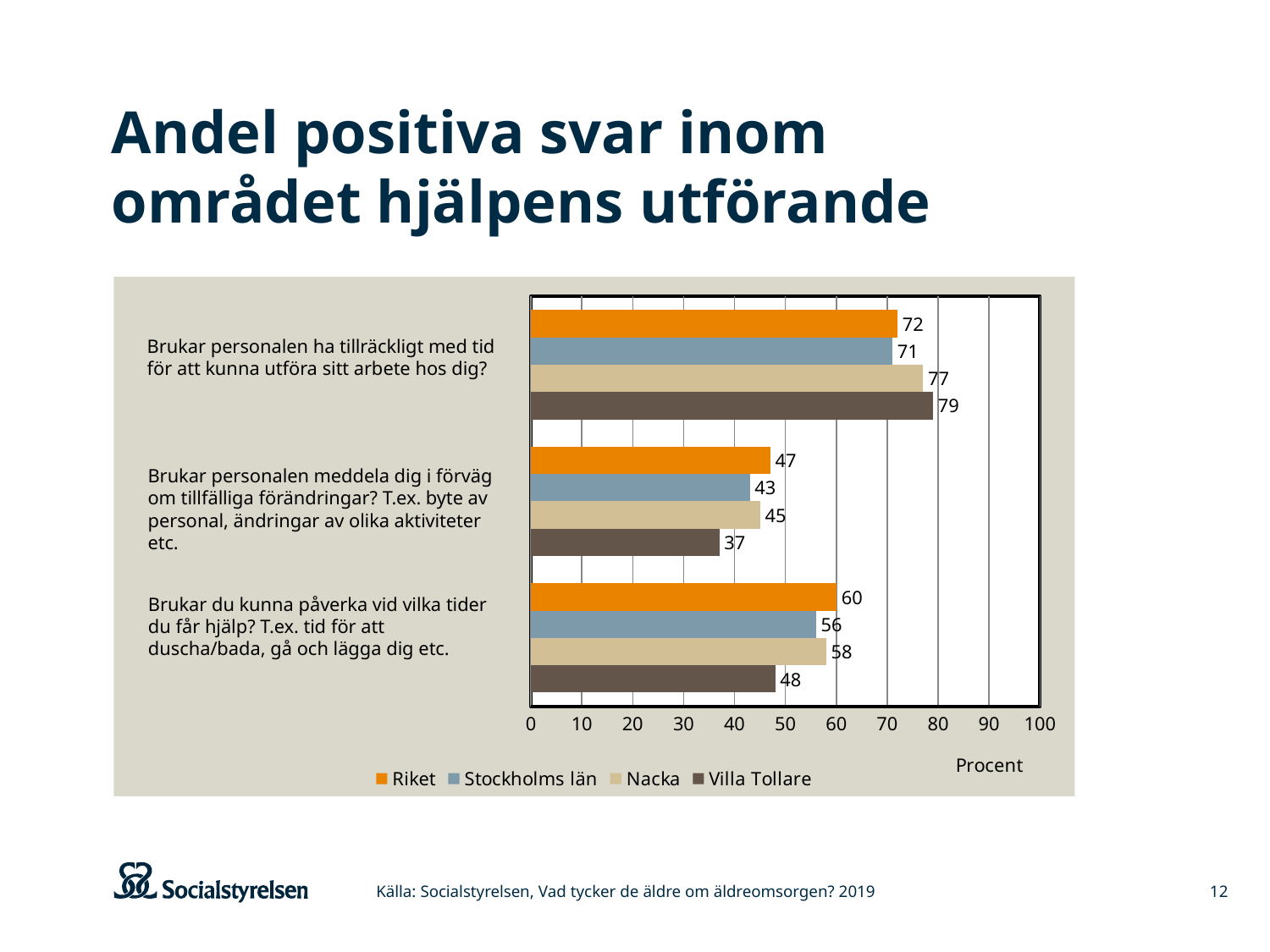
What is the value for Riket on the question "Brukar du kunna påverka vid vilka tider du får hjälp?"? 60 What kind of chart is shown on the slide? Bar chart How many questions (categories) are shown in the chart? 3 Which series is shown in orange in the legend? Riket Which series has the highest value on the question "Brukar personalen ha tillräckligt med tid för att kunna utföra sitt arbete hos dig?"? Villa Tollare How many series does the legend list? 4 What is the value for Villa Tollare on the question "Brukar personalen ha tillräckligt med tid för att kunna utföra sitt arbete hos dig?"? 79 What is the label on the horizontal axis of the chart? Procent Which series has the lowest value on the question "Brukar du kunna påverka vid vilka tider du får hjälp?"? Villa Tollare What is the difference between Nacka and Villa Tollare on the question "Brukar personalen meddela dig i förväg om tillfälliga förändringar?"? 8 What is the value for Stockholms län on the question "Brukar personalen meddela dig i förväg om tillfälliga förändringar?"? 43 Which is larger on the question "Brukar du kunna påverka vid vilka tider du får hjälp?": Stockholms län or Nacka? Nacka